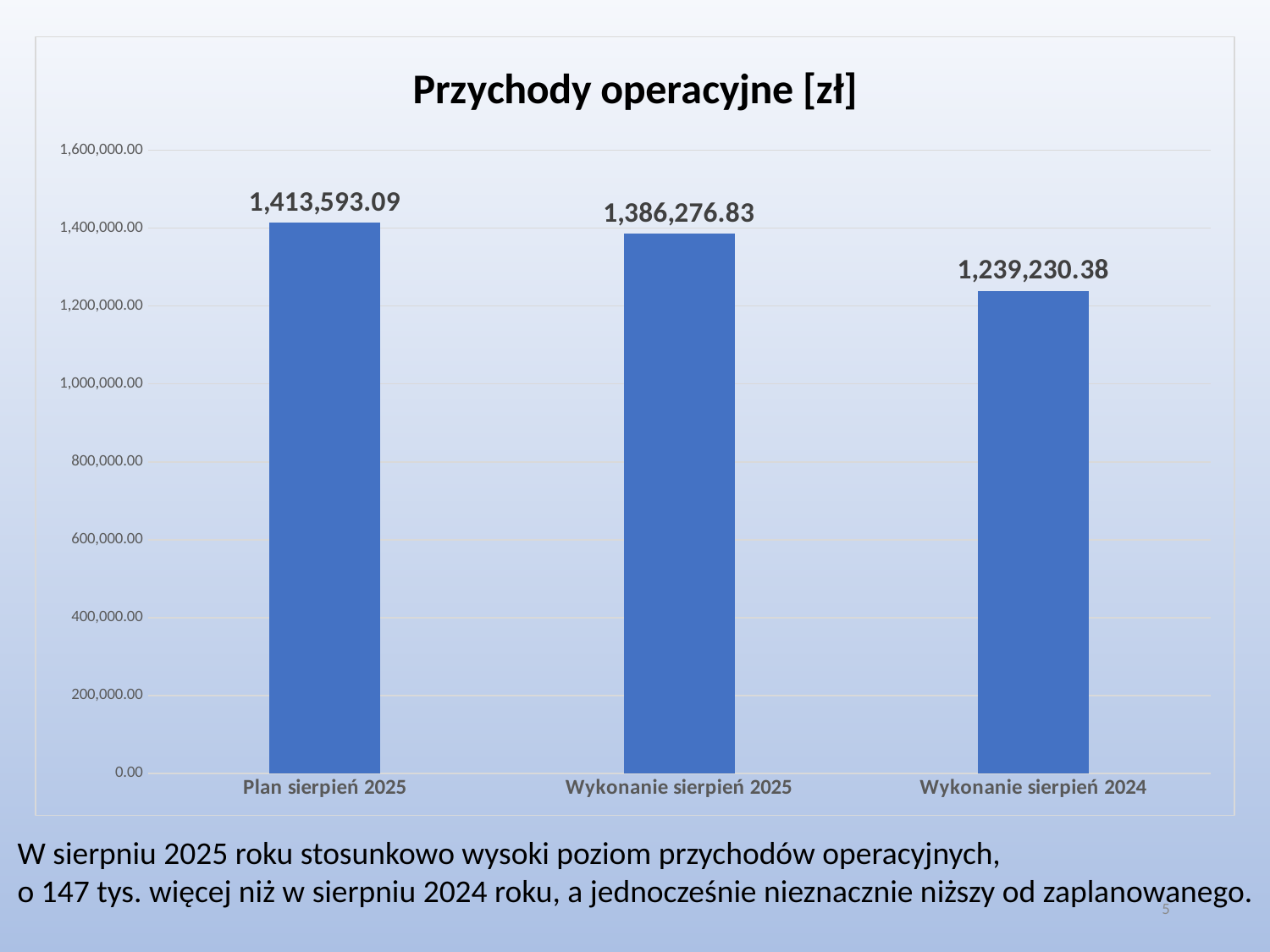
What is the difference between Plan sierpień 2025 and Wykonanie sierpień 2025? 27,316.26 How many categories are shown on the chart? 3 What is the value for Wykonanie sierpień 2025? 1,386,276.83 Which category has the lowest value? Wykonanie sierpień 2024 What is the title of the chart? Przychody operacyjne [zł] Which category has the highest value? Plan sierpień 2025 Is the value for Wykonanie sierpień 2024 greater or less than 1,200,000.00? greater What is the value for Plan sierpień 2025? 1,413,593.09 What kind of chart is shown on the slide? bar chart What is the value for Wykonanie sierpień 2024? 1,239,230.38 What is the difference between Wykonanie sierpień 2025 and Wykonanie sierpień 2024? 147,046.45 Which is larger, Wykonanie sierpień 2025 or Wykonanie sierpień 2024? Wykonanie sierpień 2025